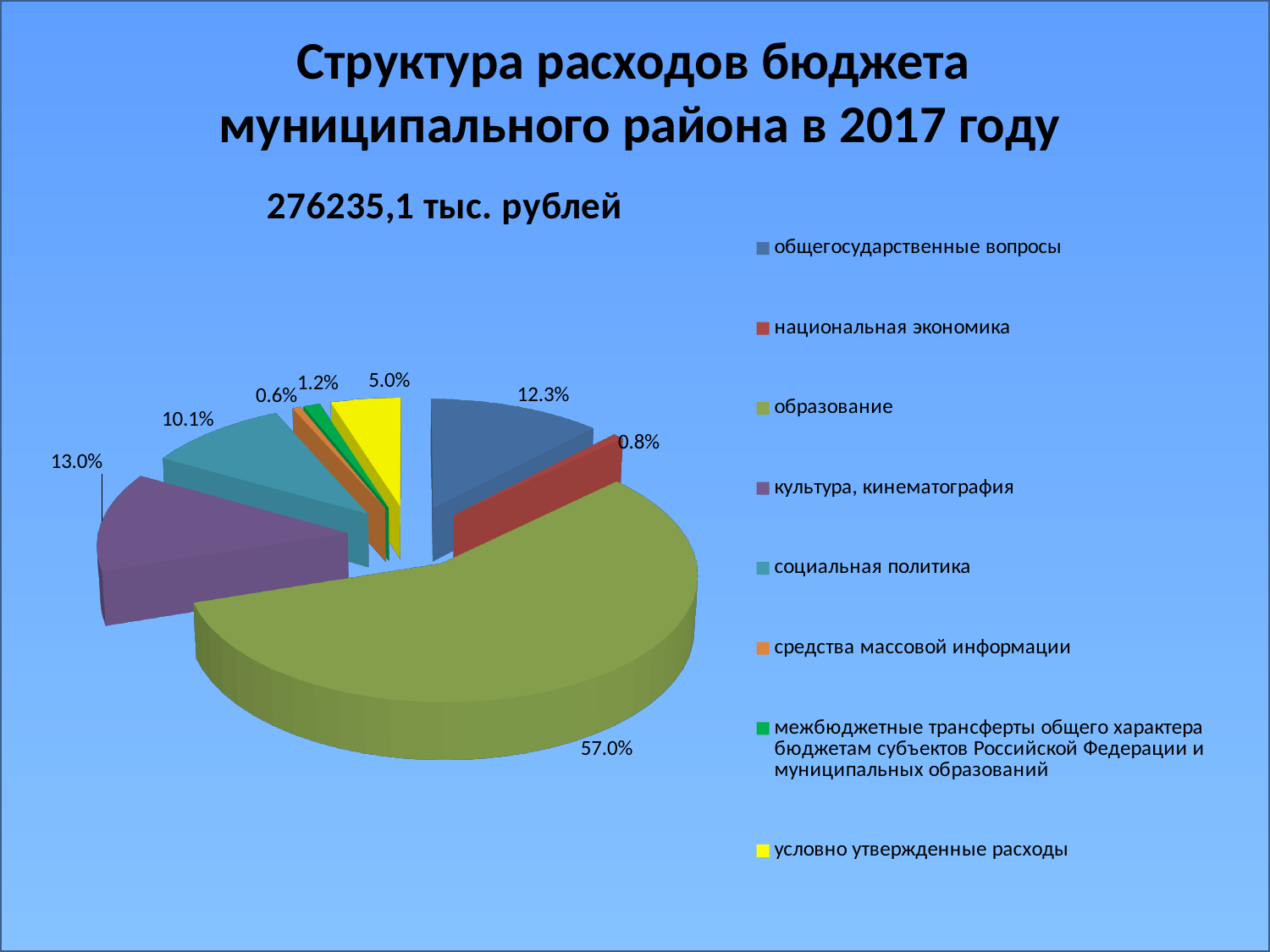
What share of the pie does средства массовой информации have? 0.6% What share of the pie does условно утвержденные расходы have? 5.0% What share of the pie does общегосударственные вопросы have? 12.3% How many categories does the legend list? 8 What kind of chart is shown on the slide? pie chart Which is larger: the share for культура, кинематография or the share for социальная политика? культура, кинематография What is the difference between the share for общегосударственные вопросы and the share for условно утвержденные расходы? 7.3% Which category has the smallest share of the pie? средства массовой информации Which category has the largest share of the pie? образование